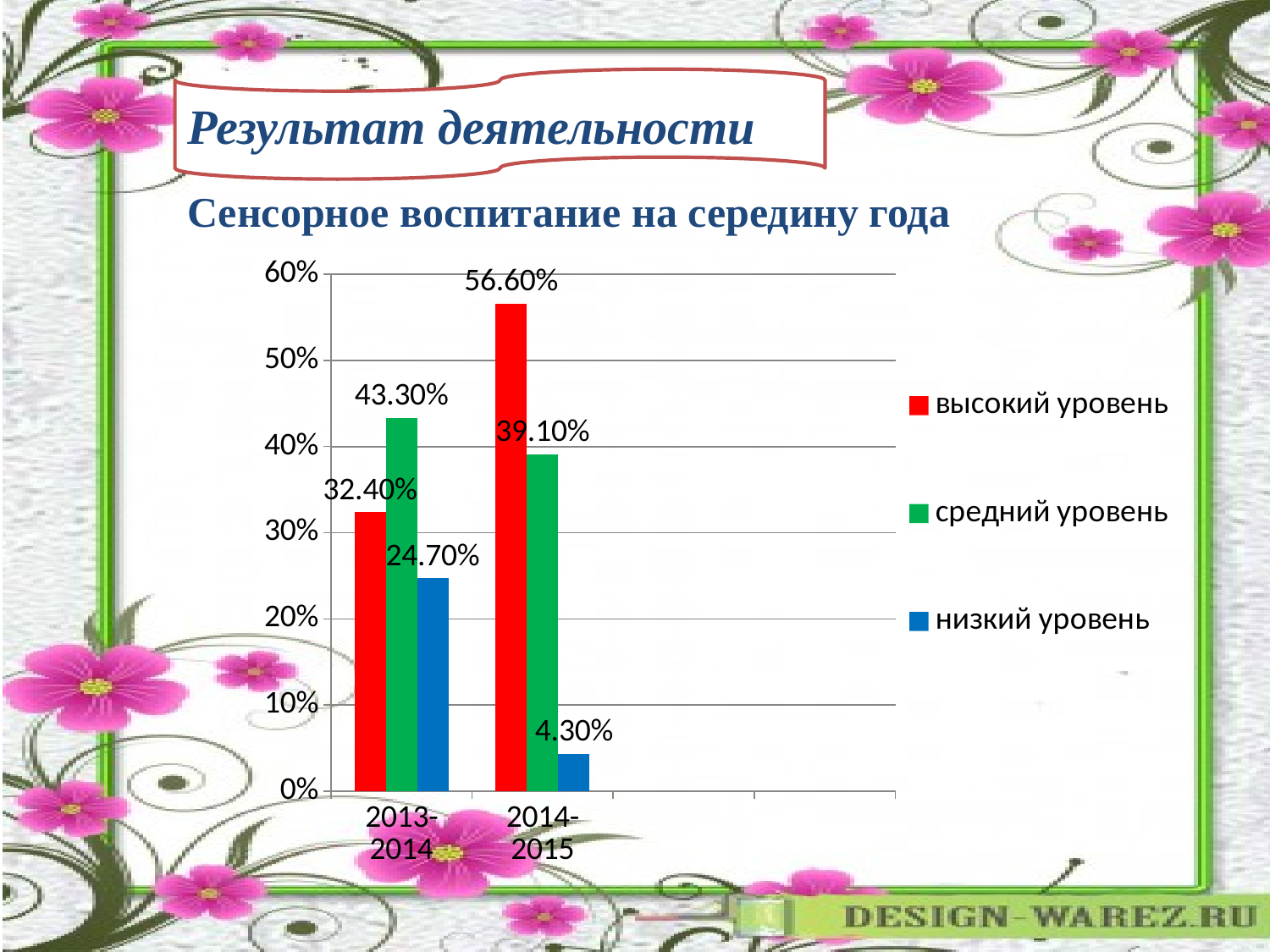
What is the difference between высокий уровень in 2014-2015 and in 2013-2014? 24.20% Does the value for низкий уровень rise or fall from 2013-2014 to 2014-2015? fall What is the value for высокий уровень in 2014-2015? 56.60% What is the value for высокий уровень in 2013-2014? 32.40% What kind of chart is shown on the slide? bar chart What is the value for средний уровень in 2013-2014? 43.30% What is the value for низкий уровень in 2014-2015? 4.30% Which series has the highest value in 2013-2014? средний уровень Which series has the lowest value in 2014-2015? низкий уровень How many series does the legend list? 3 Which is larger: средний уровень in 2013-2014 or средний уровень in 2014-2015? средний уровень in 2013-2014 How many categories are shown on the x axis? 2